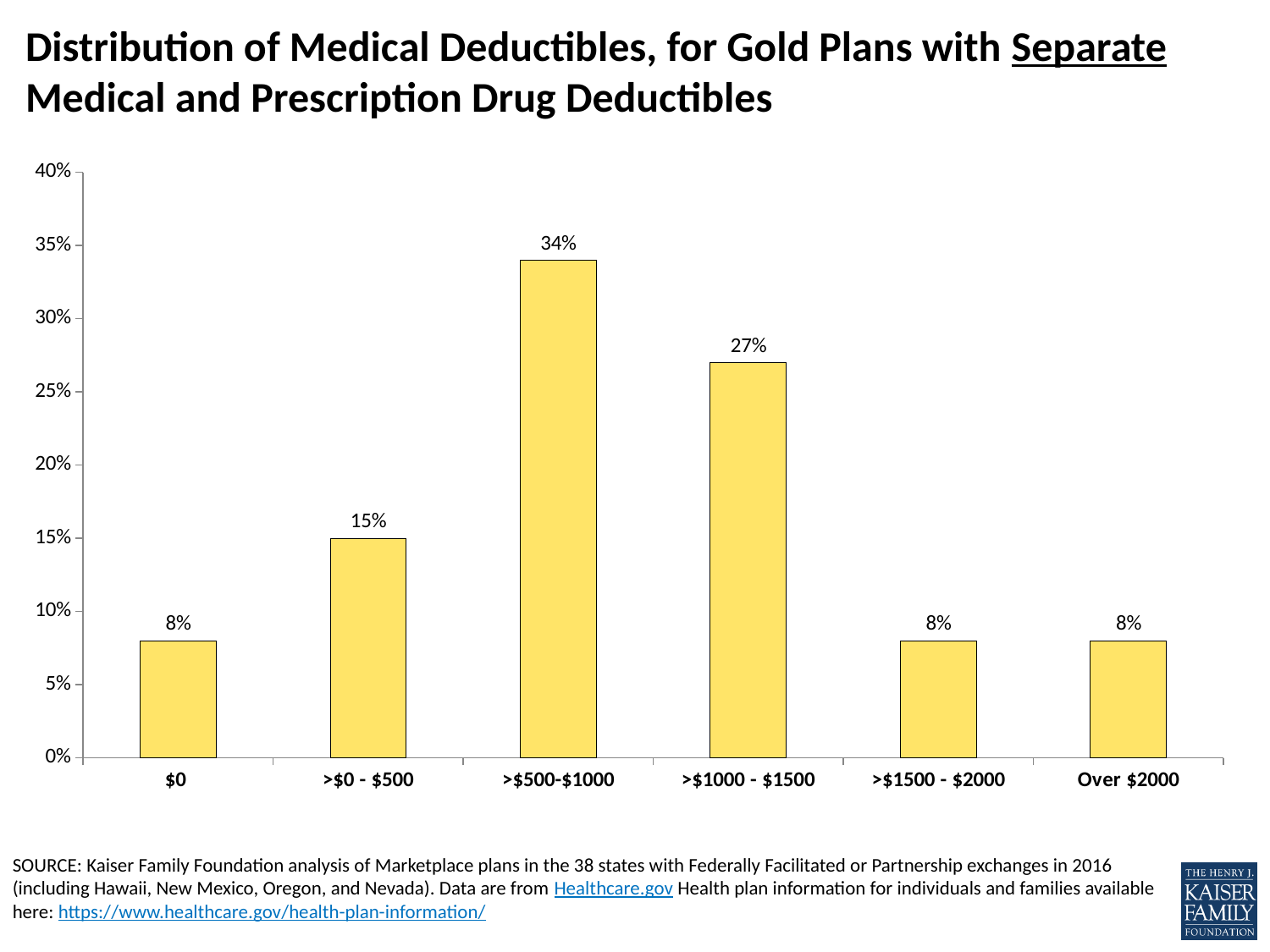
What kind of chart is shown on the slide? Bar chart What percentage of gold plans with separate deductibles have a medical deductible of >$500-$1000? 34% How many categories share the lowest value of 8%? 3 Which deductible category has the highest share of plans? >$500-$1000 What is the value shown for the >$0 - $500 deductible category? 15% What is the difference between the >$500-$1000 and >$1000 - $1500 categories? 7 percentage points How many deductible categories are shown on the x axis? 6 Is the value for >$1000 - $1500 greater or less than 25%? greater What percentage of plans have a $0 medical deductible? 8% What is the value for the >$1000 - $1500 category? 27% What is the maximum value shown on the y axis? 40% Which is larger, the value for >$0 - $500 or the value for Over $2000? >$0 - $500